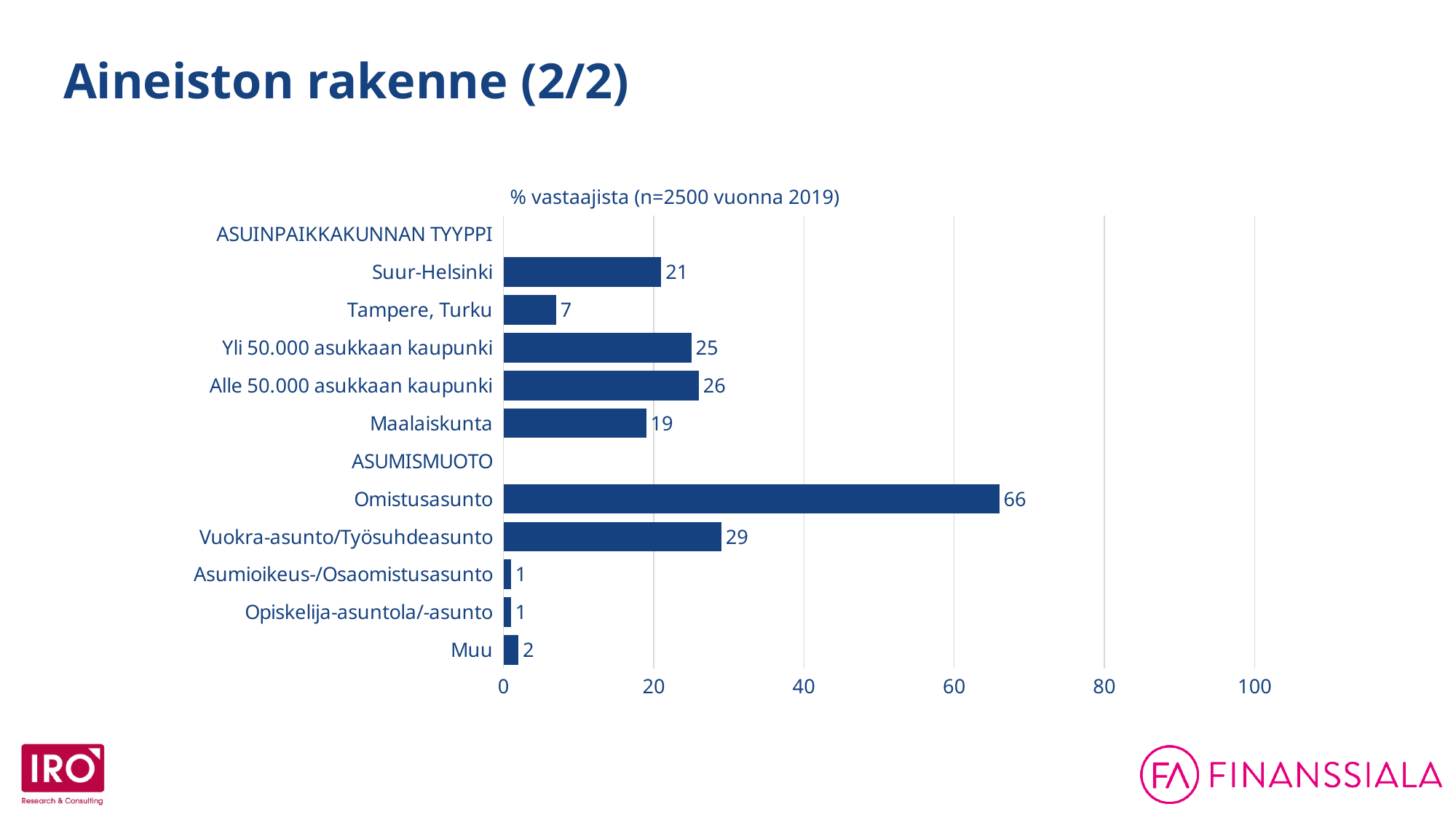
What is the value for Vuokra-asunto/Työsuhdeasunto? 29 Which category under ASUINPAIKKAKUNNAN TYYPPI has the lowest value? Tampere, Turku What is the difference between the values for Omistusasunto and Vuokra-asunto/Työsuhdeasunto? 37 What is the difference between the values for Alle 50.000 asukkaan kaupunki and Tampere, Turku? 19 What is the value for Suur-Helsinki? 21 What kind of chart is shown on the slide? bar chart What is the title shown above the chart? % vastaajista (n=2500 vuonna 2019) Which is larger, the value for Suur-Helsinki or the value for Maalaiskunta? Suur-Helsinki What is the value for Omistusasunto? 66 What is the value for Maalaiskunta? 19 Which category has the highest value in the chart? Omistusasunto Is the value for Omistusasunto greater or less than 60? greater